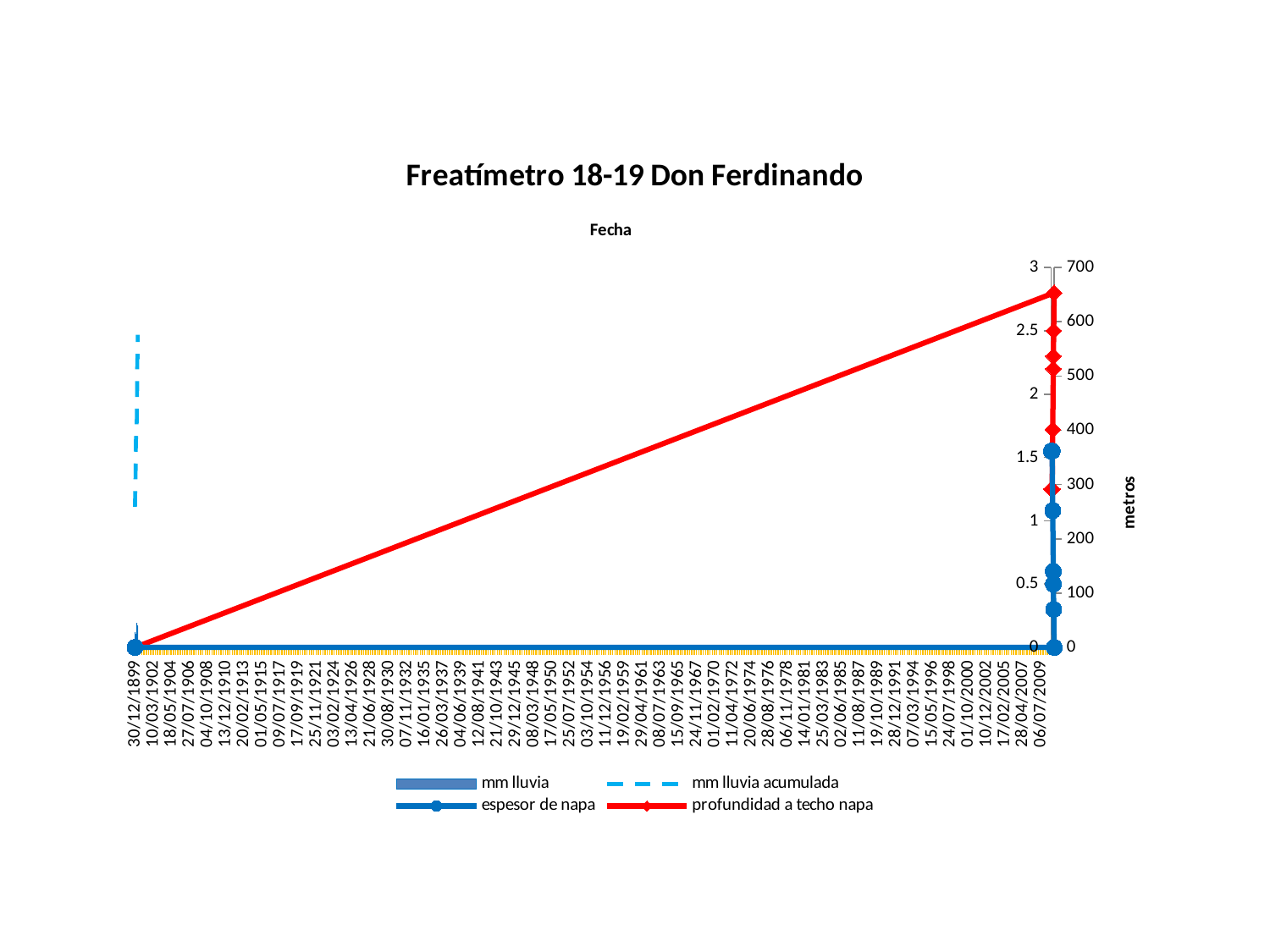
Does the 'profundidad a techo napa' line rise or fall from left to right along the x axis? rise How many series does the legend list? 4 What kind of chart is shown? combination bar and line chart What is the label of the right vertical axis? metros Is the highest point of the 'profundidad a techo napa' line greater or less than 600 on the right axis? greater What is the title of the chart? Freatímetro 18-19 Don Ferdinando